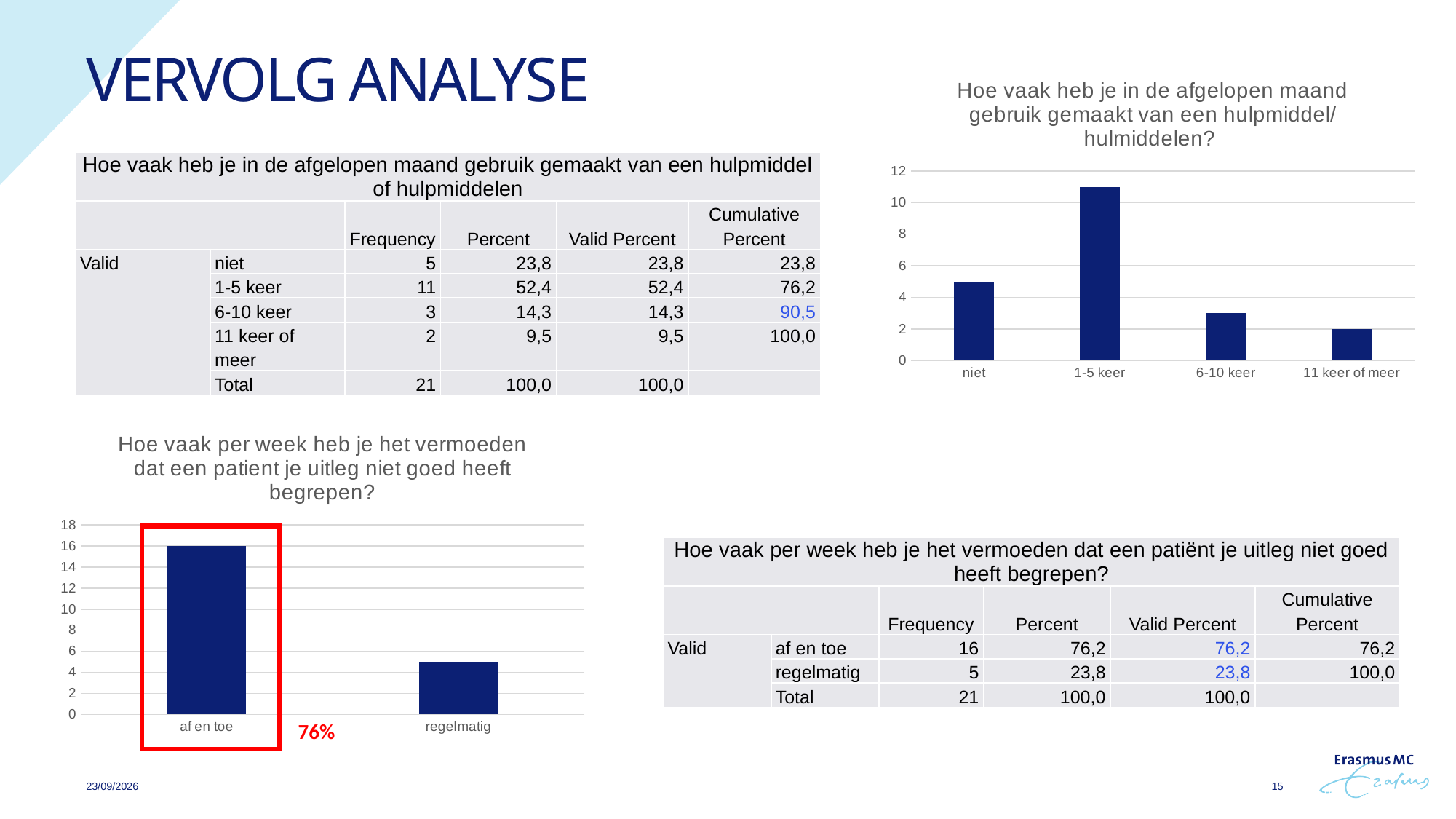
In the bottom-left chart titled 'Hoe vaak per week heb je het vermoeden dat een patient je uitleg niet goed heeft begrepen?', what is the value for 'af en toe'? 16 In the top-right chart, which is larger, the bar for 'niet' or the bar for '6-10 keer'? niet How many categories are shown on the x axis of the top-right chart? 4 In the top-right chart, what is the value for '11 keer of meer'? 2 In the top-right chart, is the value for 'niet' greater or less than 4? greater In the top-right chart, which category has the highest bar? 1-5 keer How many categories are shown on the x axis of the bottom-left chart? 2 What percentage is printed in red next to the highlighted bar in the bottom-left chart? 76% In the top-right chart, is the value for '1-5 keer' greater or less than 10? greater In the top-right chart, which category has the lowest bar? 11 keer of meer What type of chart is the top-right chart titled 'Hoe vaak heb je in de afgelopen maand gebruik gemaakt van een hulpmiddel/hulmiddelen?'? bar chart In the bottom-left chart, which category has the highest bar? af en toe